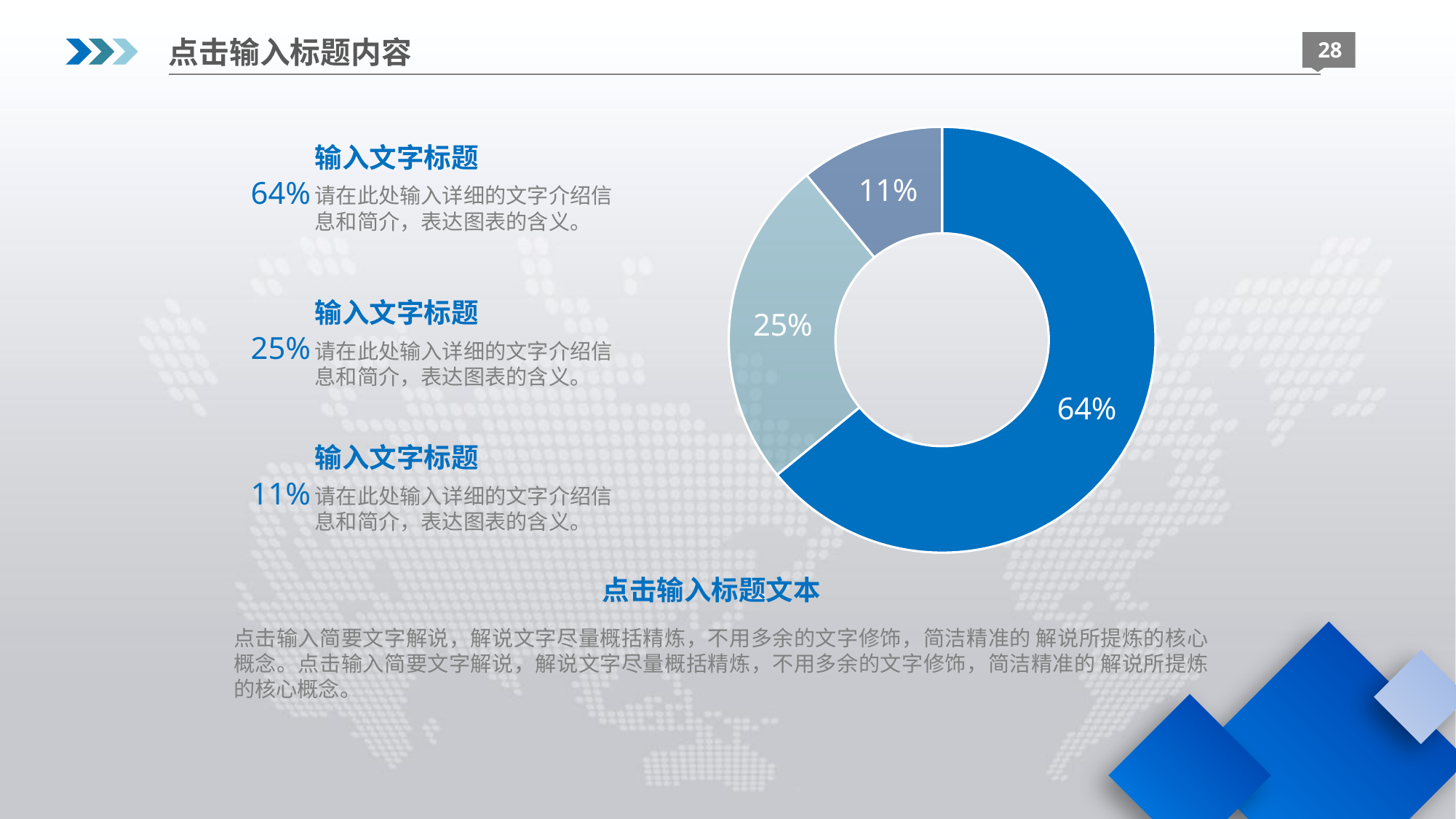
How many slices does the donut chart have? 3 What kind of chart is shown on the slide? Donut chart What percentage is labelled on the light grey-blue slice on the left of the donut chart? 25% Which is larger in the donut chart, the dark blue slice or the light grey-blue slice? The dark blue slice What percentage is labelled on the dark blue slice of the donut chart? 64% What is the smallest share shown in the donut chart? 11% What percentage is labelled on the small slice at the top of the donut chart? 11% What is the difference between the largest and smallest slices of the donut chart? 53% Is the share of the dark blue slice greater or less than 50%? greater What is the difference between the 25% slice and the 11% slice of the donut chart? 14% What is the total of the three percentages shown in the donut chart? 100% What is the largest share shown in the donut chart? 64%